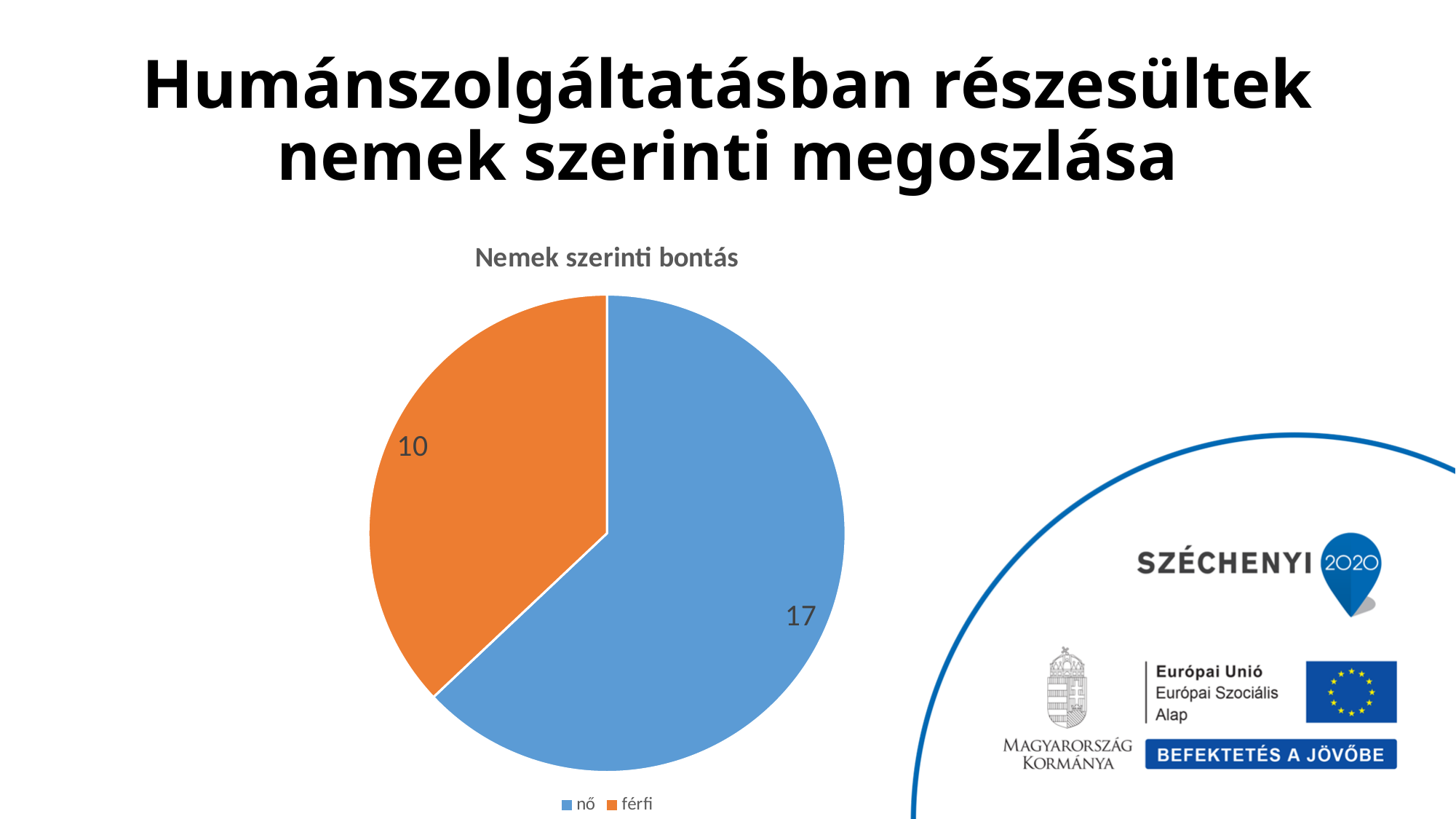
How many slices does the pie chart have? 2 What is the total of all slices in the pie chart? 27 What is the value for férfi in the pie chart? 10 What is the title of the chart? Nemek szerinti bontás Which is larger, the value for nő or the value for férfi? nő What type of chart is shown on the slide? pie chart What is the difference between the values for nő and férfi? 7 What is the value for nő in the pie chart? 17 Which colour represents férfi in the pie chart? orange What fraction of the total does the nő slice represent? 17/27 Which category has the largest slice in the pie chart? nő Which category has the smallest slice in the pie chart? férfi